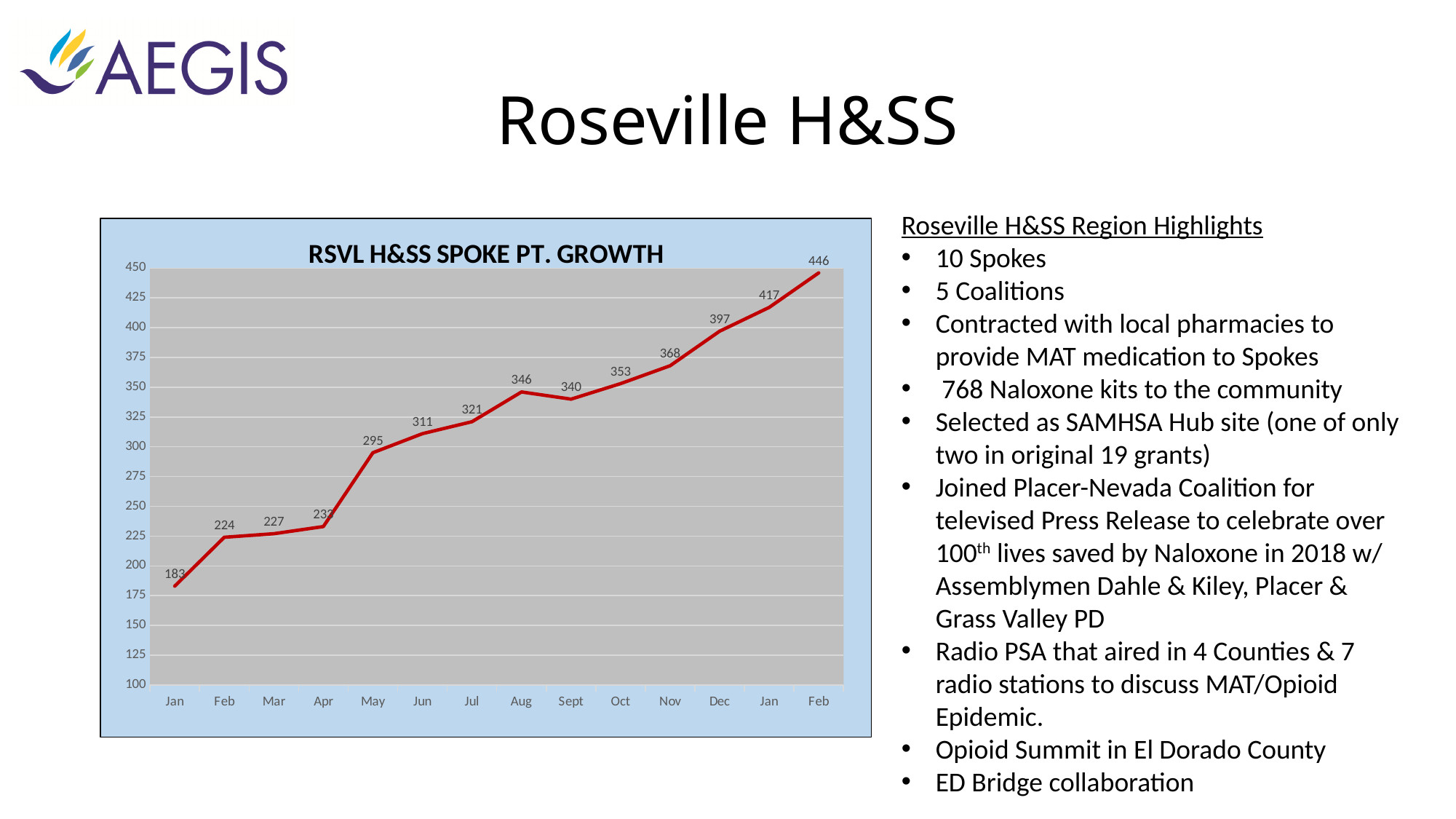
How many data points are plotted on the chart? 14 What is the value for the final Feb point on the chart? 446 What is the title of the chart? RSVL H&SS SPOKE PT. GROWTH What is the difference between the Dec value and the Nov value? 29 Which is larger, the value for Aug or the value for Sept? Aug Which month has the highest value on the chart? Feb (the last point) What is the value for the first Jan point on the chart? 183 What is the value for May in the RSVL H&SS SPOKE PT. GROWTH chart? 295 Which month has the lowest value on the chart? Jan (the first point) What is the value for Aug in the chart? 346 Do the values generally rise or fall from left to right along the x axis? rise What type of chart is shown on the slide? line chart